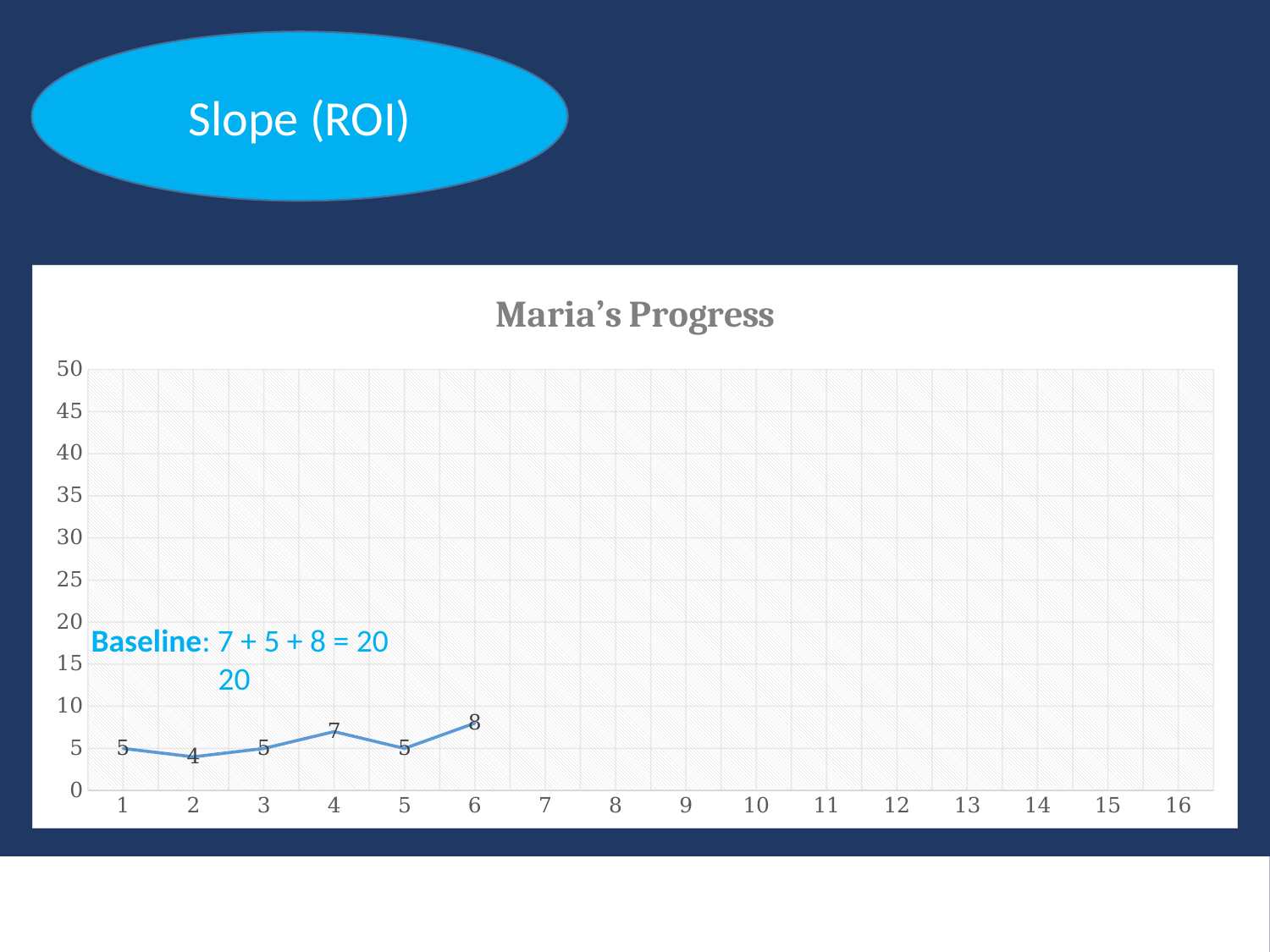
Which is larger, the value at x = 4 or the value at x = 5? x = 4 How many data points are plotted on the line? 6 Is the value at x = 6 greater or less than 10? less What is the difference between the values at x = 6 and x = 2? 4 At which x value is the plotted value highest? 6 What is the value plotted at x = 6? 8 What is the title of the chart? Maria's Progress At which x value is the plotted value lowest? 2 What kind of chart is shown on the slide? line chart What is the highest value shown on the y axis? 50 What is the value plotted at x = 4? 7 What is the value plotted at x = 2? 4